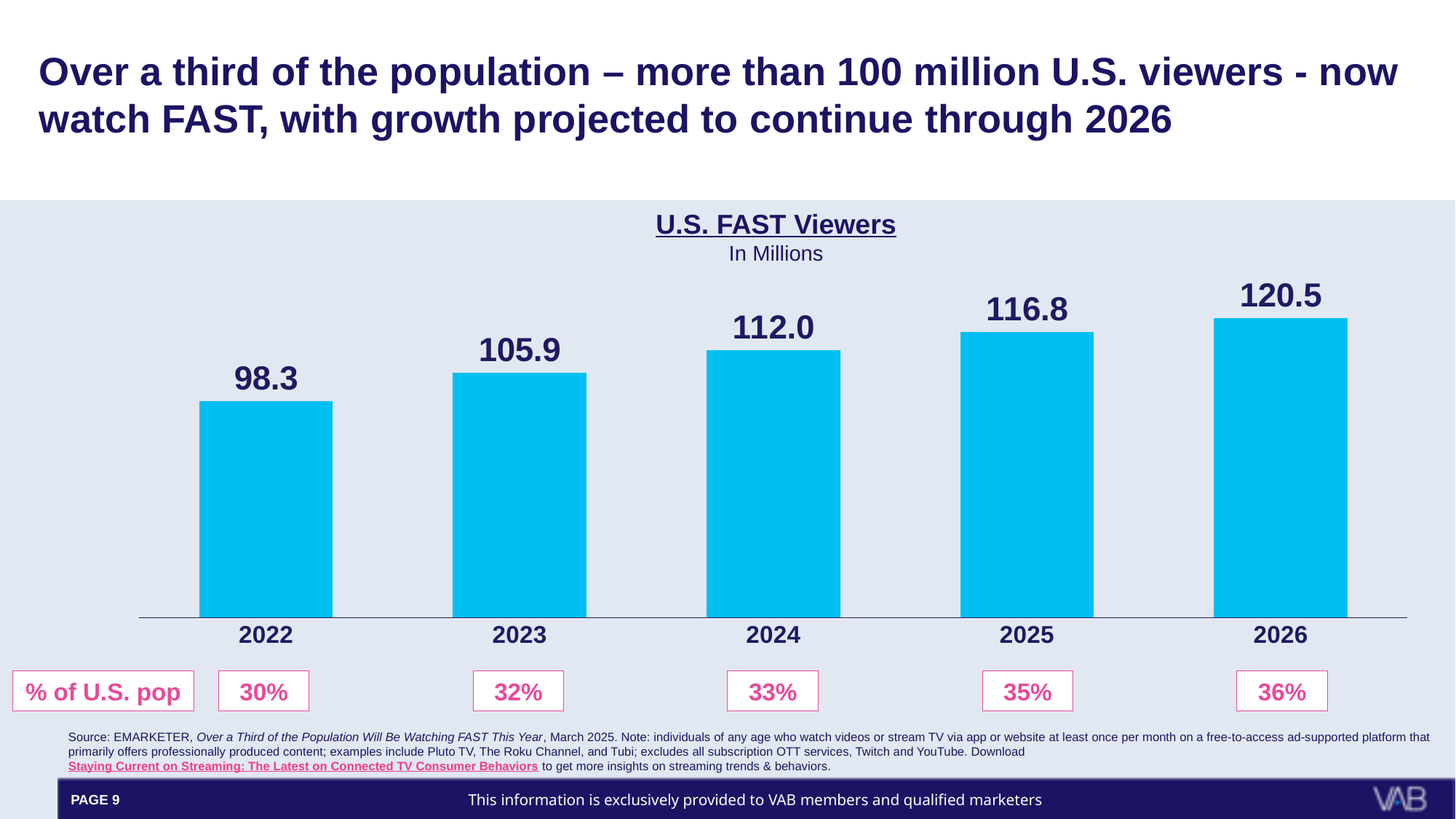
What is the value for 2024 in the U.S. FAST Viewers chart? 112.0 Which year has the highest value in the U.S. FAST Viewers chart? 2026 How many years are shown in the U.S. FAST Viewers chart? 5 Which is larger in the U.S. FAST Viewers chart, the value for 2023 or the value for 2025? 2025 What is the value for 2026 in the U.S. FAST Viewers chart? 120.5 What is the difference between the 2025 and 2022 values in the U.S. FAST Viewers chart? 18.5 Which year has the lowest value in the U.S. FAST Viewers chart? 2022 Do the values in the U.S. FAST Viewers chart rise or fall from 2022 to 2026? Rise What is the difference between the 2023 and 2022 values in the U.S. FAST Viewers chart? 7.6 What kind of chart is the U.S. FAST Viewers chart? Bar chart What is the value for 2022 in the U.S. FAST Viewers chart? 98.3 What unit is stated under the title of the U.S. FAST Viewers chart? In Millions